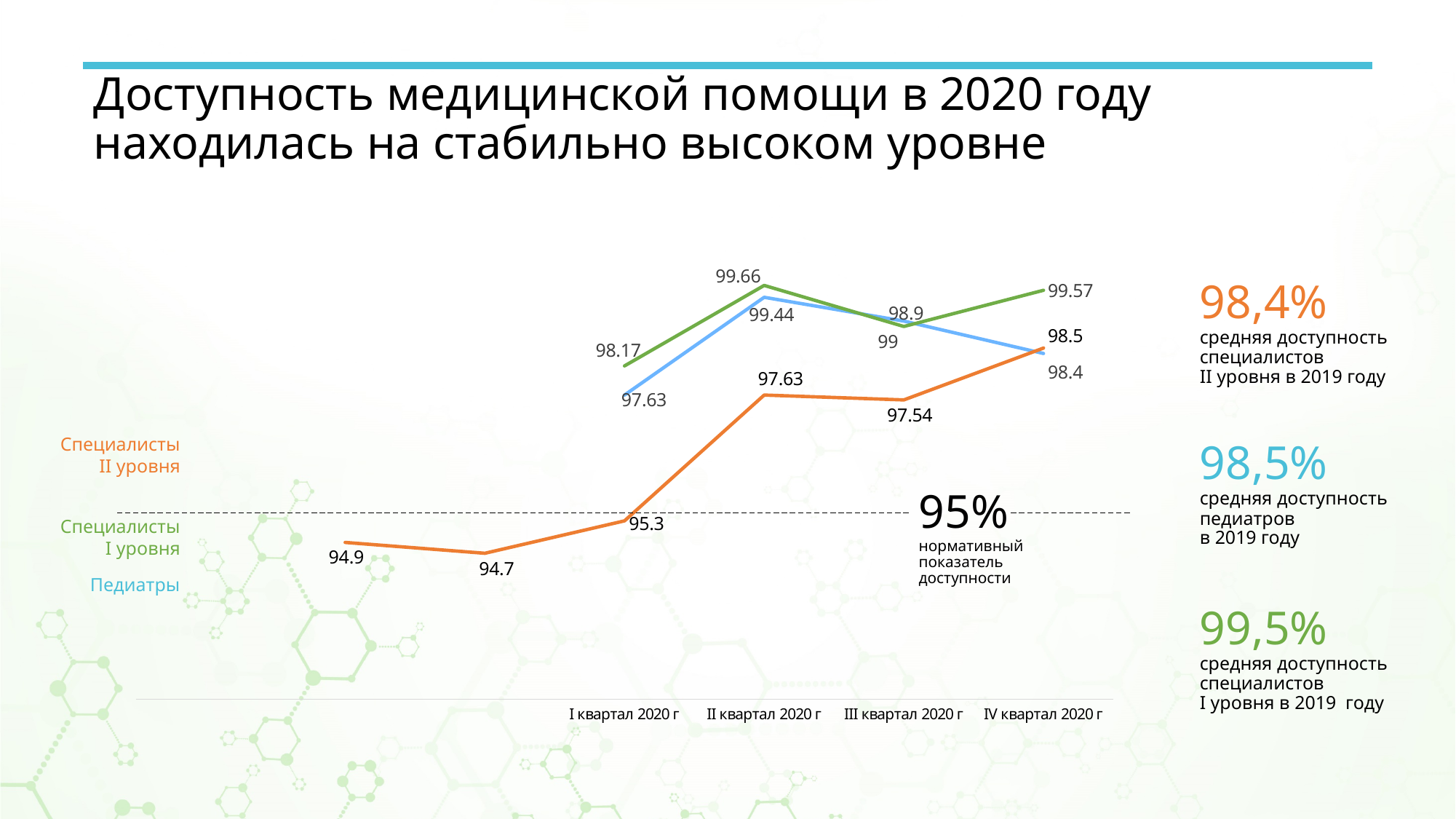
What is the difference between Специалисты I уровня and Педиатры in III квартал 2020 г? -0.1 Does the Специалисты II уровня line rise or fall from I квартал 2020 г to IV квартал 2020 г? rise What is the value for Специалисты I уровня in IV квартал 2020 г? 99.57 In which quarter does the Специалисты I уровня line reach its highest value? II квартал 2020 г Which is larger in IV квартал 2020 г: Специалисты II уровня or Педиатры? Специалисты II уровня How many series does the chart show? 3 What is the lowest value shown on the Специалисты II уровня line? 94.7 What is the value for Специалисты II уровня in III квартал 2020 г? 97.54 What type of chart is shown on the slide? line chart What normative accessibility indicator is marked by the dashed line on the chart? 95% What is the value for Специалисты I уровня in II квартал 2020 г? 99.66 What is the value for Педиатры in I квартал 2020 г? 97.63